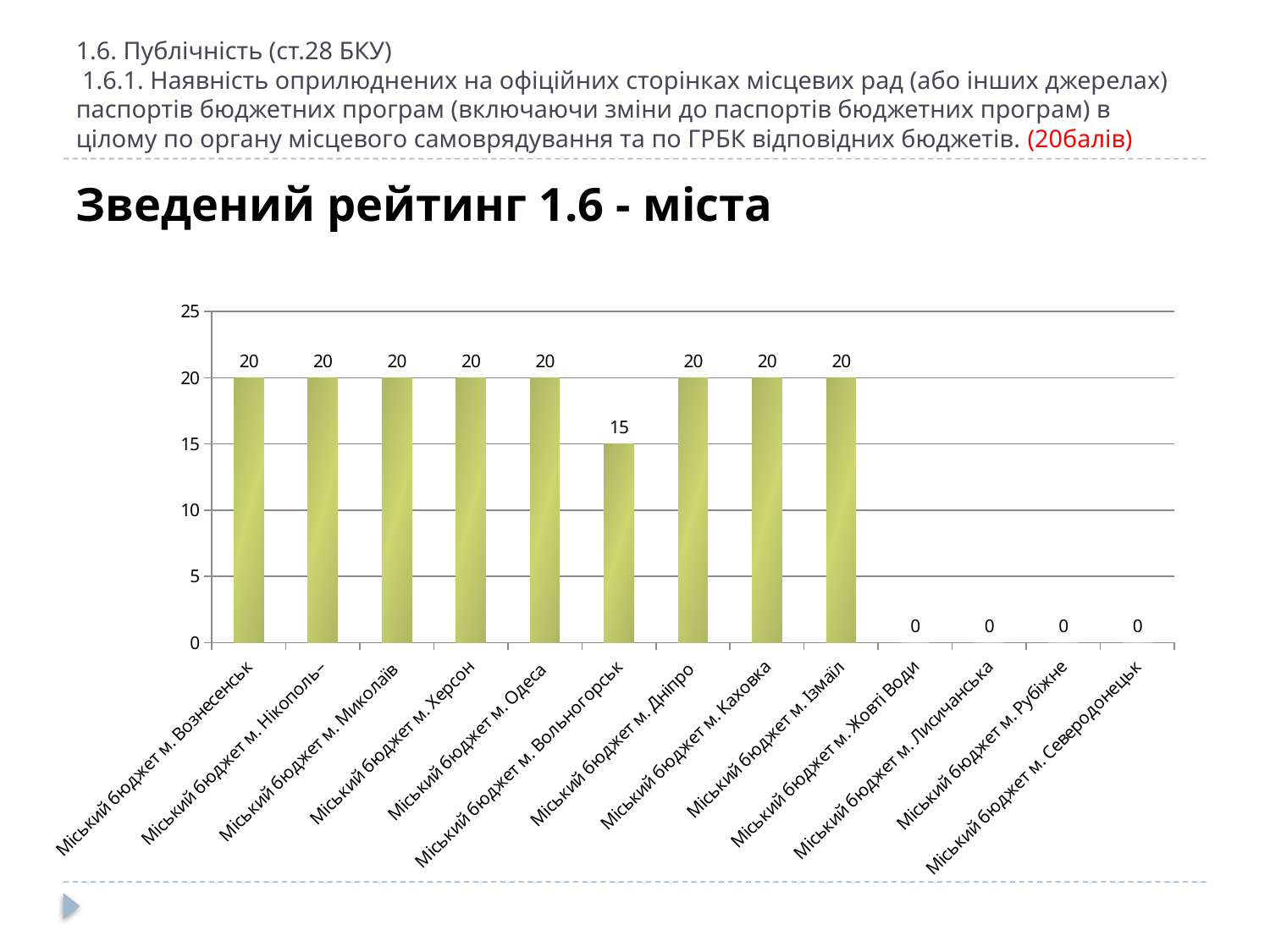
How many categories are shown on the x axis of the chart? 13 What is the value for Міський бюджет м. Ізмаїл? 20 What is the value for Міський бюджет м. Жовті Води? 0 Which is larger, the value for Міський бюджет м. Вольногорськ or the value for Міський бюджет м. Лисичанська? Міський бюджет м. Вольногорськ How many categories have a value of 0? 4 What is the title of the chart? Зведений рейтинг 1.6 - міста Which is larger, the value for Міський бюджет м. Херсон or the value for Міський бюджет м. Вольногорськ? Міський бюджет м. Херсон What is the value for Міський бюджет м. Одеса? 20 What is the difference between the values for Міський бюджет м. Дніпро and Міський бюджет м. Вольногорськ? 5 What type of chart is shown on the slide? bar chart What is the value for Міський бюджет м. Вольногорськ? 15 What is the value for Міський бюджет м. Рубіжне? 0